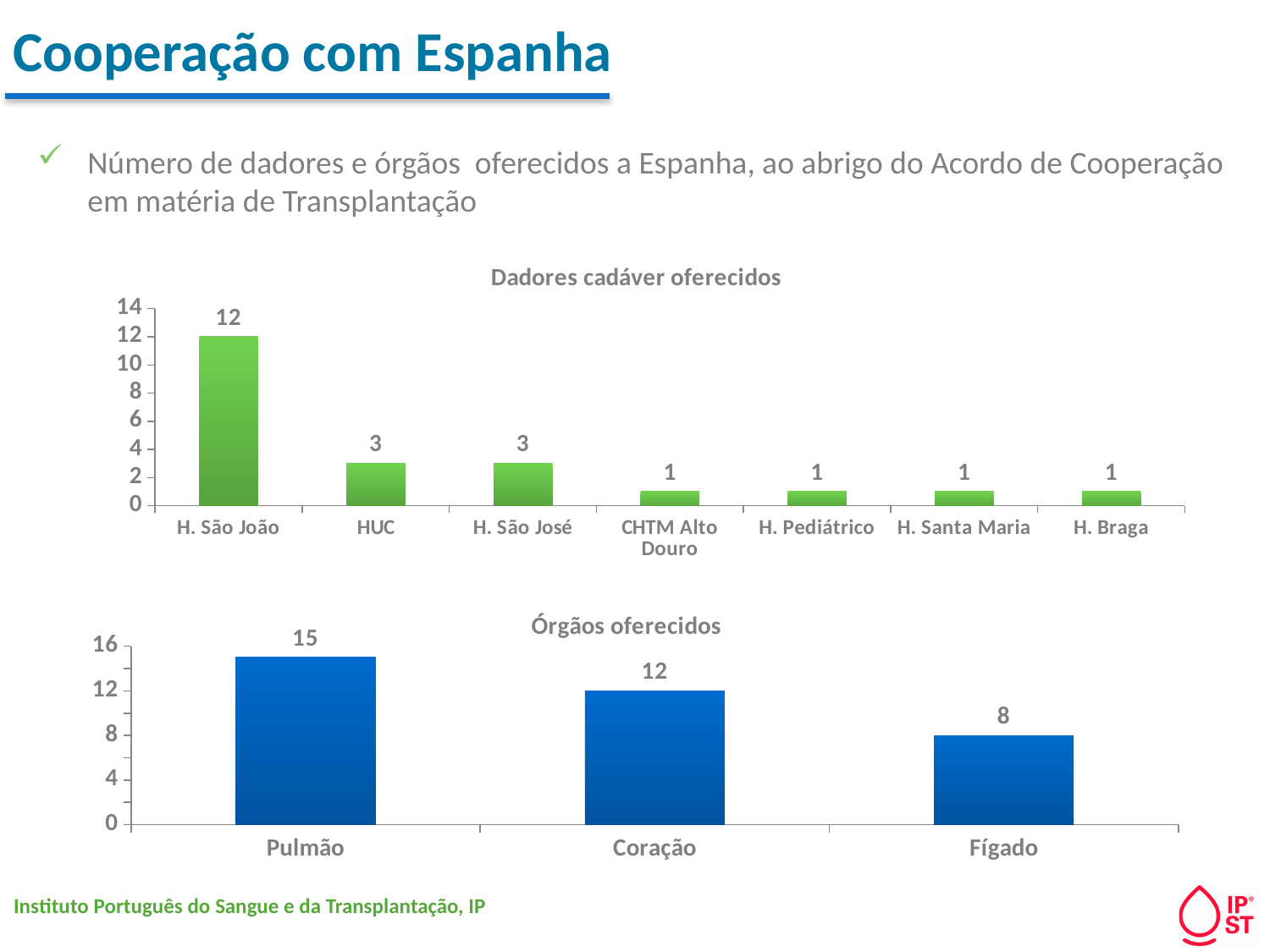
In the 'Dadores cadáver oferecidos' chart, which category has the highest value? H. São João In the 'Dadores cadáver oferecidos' chart, how many categories are shown on the x axis? 7 In the 'Dadores cadáver oferecidos' chart, what is the value for H. São João? 12 In the 'Órgãos oferecidos' chart, do the values rise or fall from left to right along the x axis? fall In the 'Órgãos oferecidos' chart, what is the difference between the values for Pulmão and Fígado? 7 In the 'Dadores cadáver oferecidos' chart, what is the value for HUC? 3 In the 'Órgãos oferecidos' chart, what is the value for Coração? 12 In the 'Órgãos oferecidos' chart, which is larger, Pulmão or Coração? Pulmão In the 'Dadores cadáver oferecidos' chart, is the value for H. São João greater or less than 10? greater In the 'Dadores cadáver oferecidos' chart, what is the difference between the values for H. São João and H. São José? 9 In the 'Órgãos oferecidos' chart, which category has the lowest value? Fígado What kind of chart is the 'Órgãos oferecidos' chart? bar chart